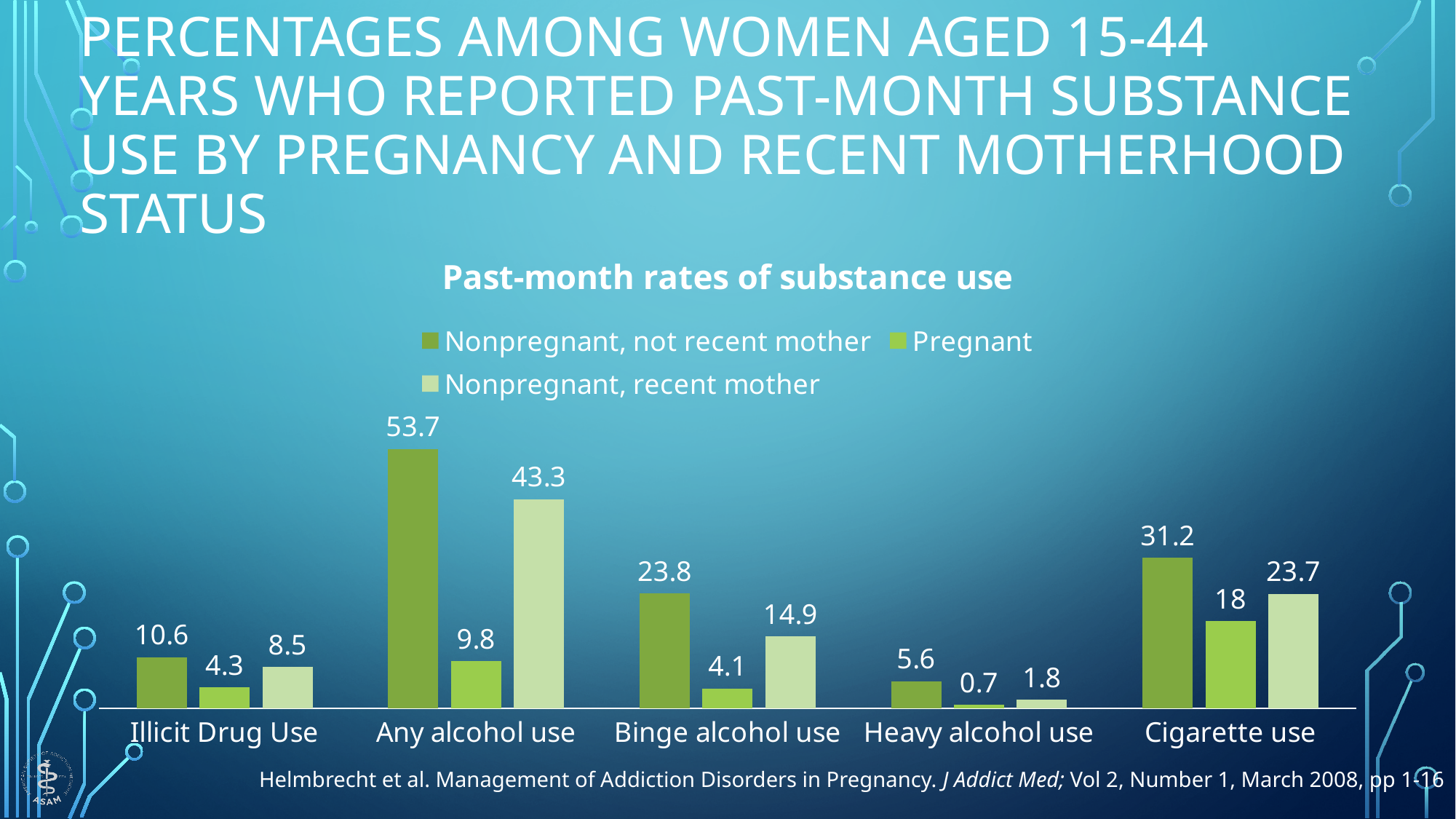
For Illicit Drug Use, which is larger: the Pregnant value or the Nonpregnant, recent mother value? Nonpregnant, recent mother Which category has the highest value for the Nonpregnant, not recent mother series? Any alcohol use What is the title of the chart? Past-month rates of substance use What is the value for Nonpregnant, recent mother for Binge alcohol use? 14.9 Which category has the lowest value for the Pregnant series? Heavy alcohol use What is the difference between the Nonpregnant, not recent mother and Pregnant values for Cigarette use? 13.2 How many series does the legend list? 3 What is the value for Pregnant women for Any alcohol use? 9.8 What is the difference between the Nonpregnant, not recent mother and Nonpregnant, recent mother values for Any alcohol use? 10.4 How many substance use categories are shown on the x axis? 5 What kind of chart is shown on the slide? Bar chart What is the value for Nonpregnant, not recent mother for Cigarette use? 31.2